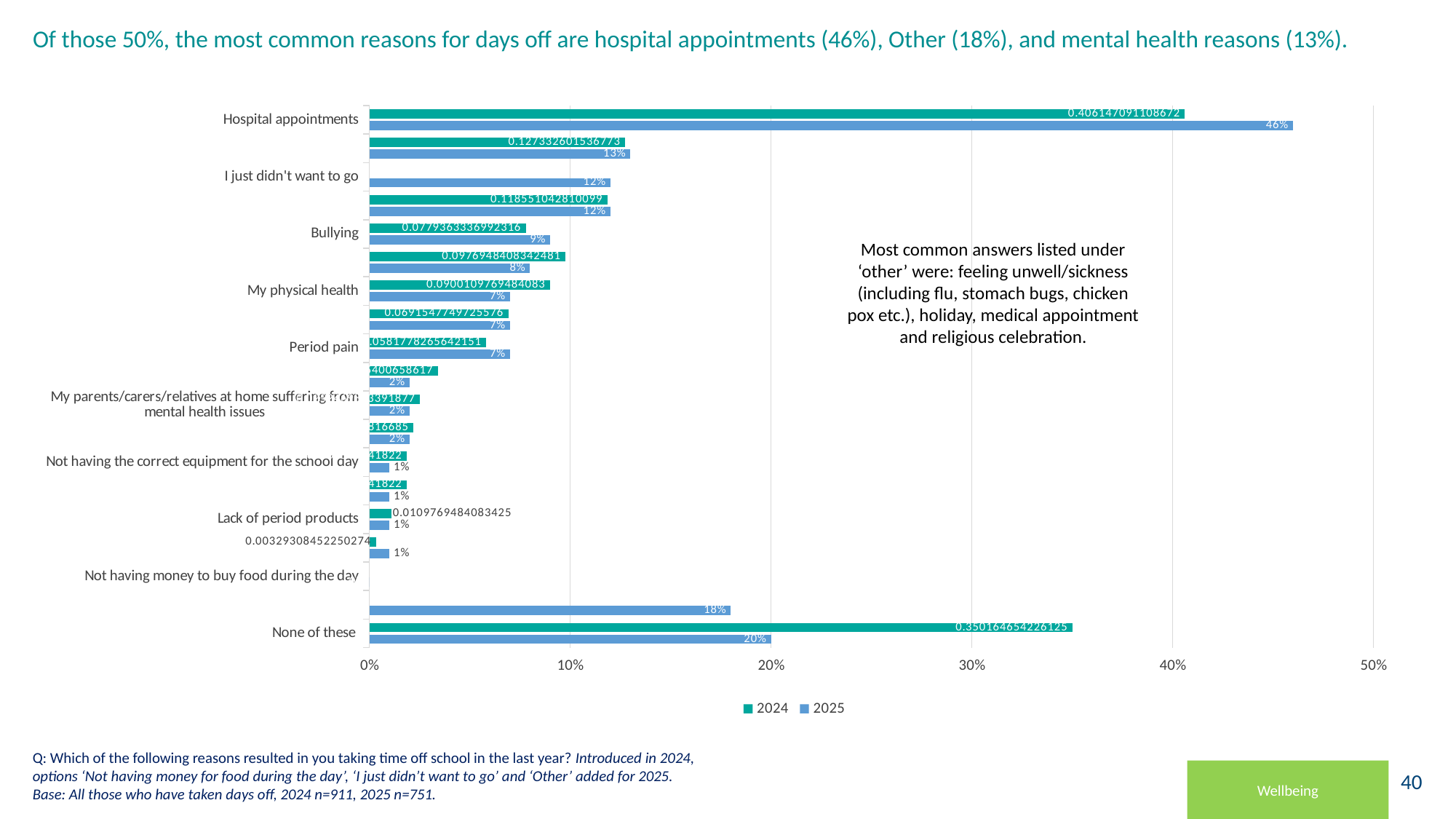
What is the 2025 value for Hospital appointments? 46% Which category has the highest 2025 value? Hospital appointments What is the 2025 value for None of these? 20% How many series does the legend list? 2 What is the difference between the 2025 values for Hospital appointments and None of these? 26 percentage points Is the 2024 value for Hospital appointments greater or less than 40%? greater What is the 2024 value for Hospital appointments, as printed on the data label? 0.406147091108672 What is the 2025 value for I just didn't want to go? 12% What kind of chart is shown on the slide? Bar chart What is the 2024 value for None of these, as printed on the data label? 0.350164654226125 What is the 2025 value for Bullying? 9% Which is larger for 2025: Hospital appointments or None of these? Hospital appointments